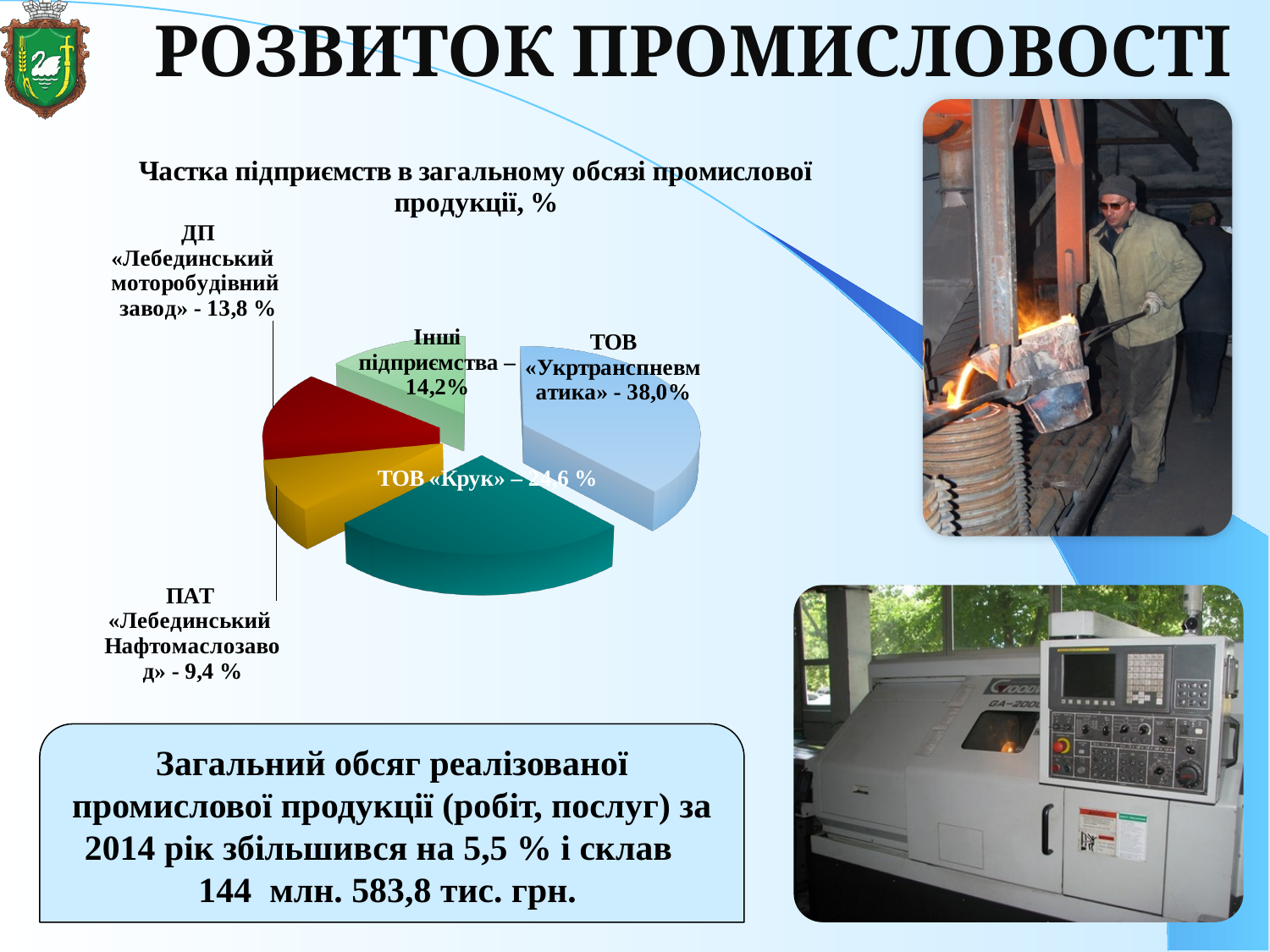
What share does ДП «Лебединський моторобудівний завод» have in the pie chart? 13,8 % What share does ПАТ «Лебединський Нафтомаслозавод» have in the pie chart? 9,4 % Which enterprise has the smallest share in the pie chart? ПАТ «Лебединський Нафтомаслозавод» Which has a larger share: «Інші підприємства» or ДП «Лебединський моторобудівний завод»? Інші підприємства What type of chart is shown on the slide? Pie chart What is the title of the chart on the slide? Частка підприємств в загальному обсязі промислової продукції, % What share is shown for «Інші підприємства» in the pie chart? 14,2% Which enterprise has the largest share in the pie chart? ТОВ «Укртранспневматика» What is the difference between the shares of ТОВ «Укртранспневматика» and ДП «Лебединський моторобудівний завод»? 24,2 % What share of total industrial output does ТОВ «Укртранспневматика» hold according to the pie chart? 38,0% What colour is the slice for ТОВ «Укртранспневматика»? Light blue How many slices does the pie chart have? 5